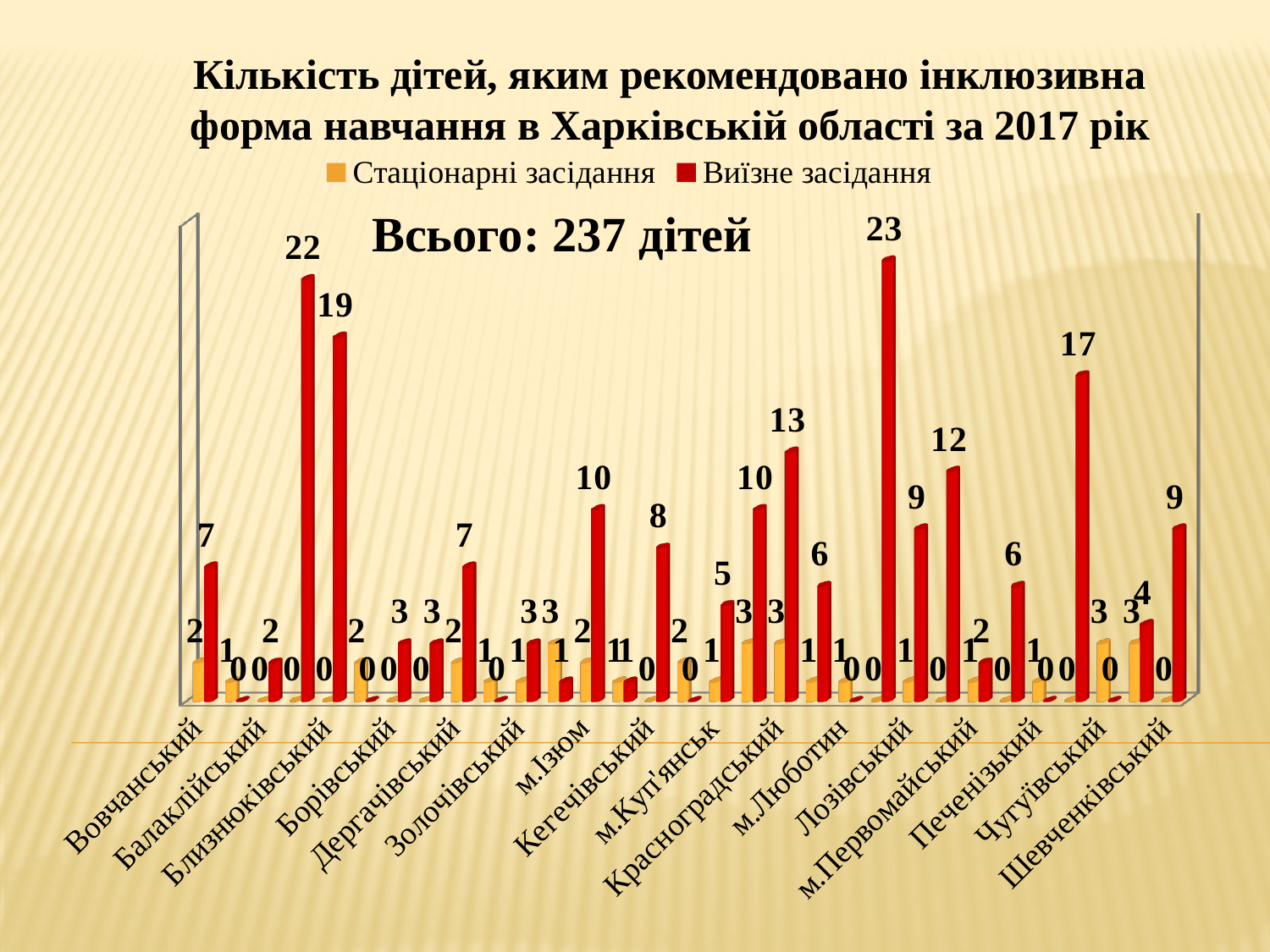
What is the highest value shown for the Виїзне засідання series? 23 How many series does the legend list? 2 What is the highest value shown for the Стаціонарні засідання series? 3 For Вовчанський, what is the difference between Виїзне засідання and Стаціонарні засідання? 5 What is the value of Стаціонарні засідання for Вовчанський? 2 What kind of chart is shown on the slide? bar chart What total number of children is stated on the chart? 237 For Вовчанський, which series has the larger value? Виїзне засідання What is the value of Виїзне засідання for Вовчанський? 7 What are the two series named in the legend? Стаціонарні засідання and Виїзне засідання Which series contains the tallest bar on the chart? Виїзне засідання